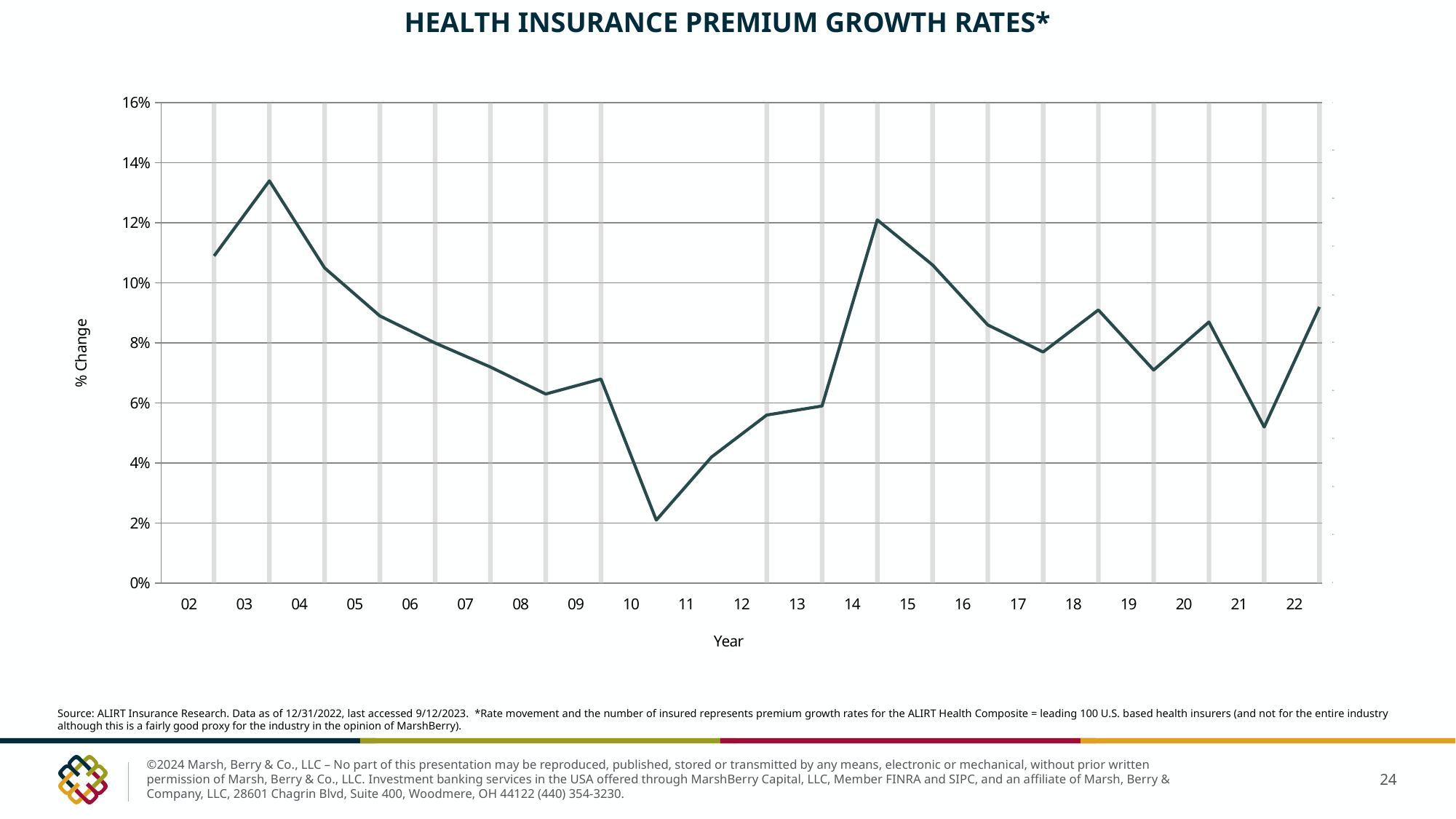
Which year has the larger growth rate, 03 or 14? 03 What is the label on the vertical axis of the chart? % Change Is the value for year 14 greater or less than 10%? greater Is the value for year 10 greater or less than 4%? less What kind of chart is shown on the slide? Line chart Which year has the larger growth rate, 11 or 18? 18 In which year is the health insurance premium growth rate lowest? 10 Do the values rise or fall from year 03 to year 08? fall Is the value for year 21 greater or less than 6%? less In which year is the health insurance premium growth rate highest? 03 What is the title of the chart? HEALTH INSURANCE PREMIUM GROWTH RATES* How many years are plotted on the x axis of the chart? 21